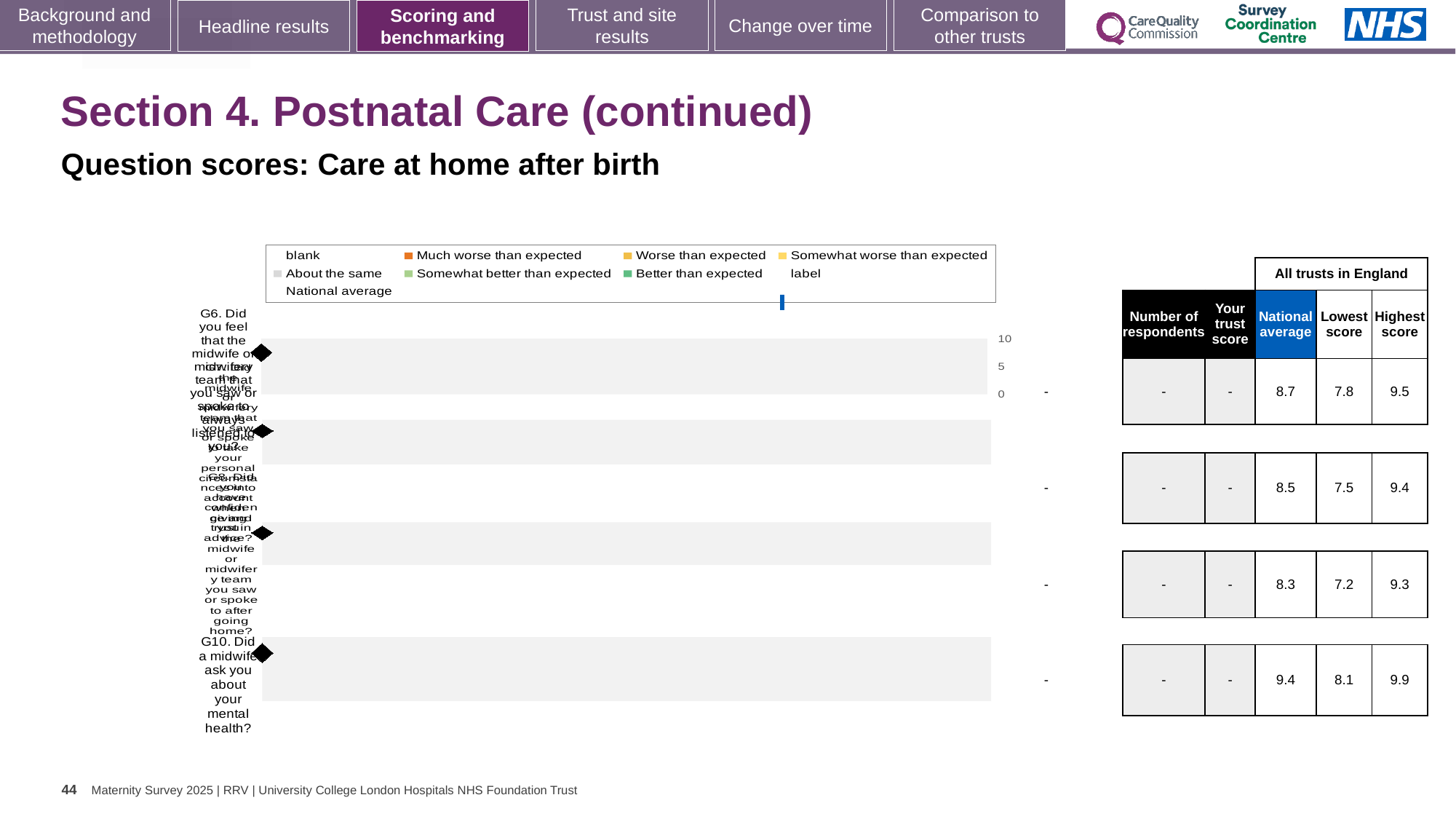
In the table beside the chart, what is the national average for the first row (G6)? 8.7 How many question rows are plotted on the chart? 4 What kind of chart is shown on the slide? bar chart Which row has the highest national average in the table beside the chart? G10 (9.4) What colour does the chart legend use for 'Much worse than expected'? orange In the table beside the chart, what is the highest score for the first row (G6)? 9.5 In the table beside the chart, is the national average for the first row (G6) larger or smaller than that for the G10 row? smaller In the table beside the chart, what is the difference between the highest score and the lowest score for the G10 row? 1.8 In the table beside the chart, what is the lowest score for the G10 row? 8.1 What is the highest value shown on the chart's numeric axis? 10 In the table beside the chart, what is the national average for the G10 row (Did a midwife ask you about your mental health?)? 9.4 In the table beside the chart, what is the highest score for the G10 row? 9.9